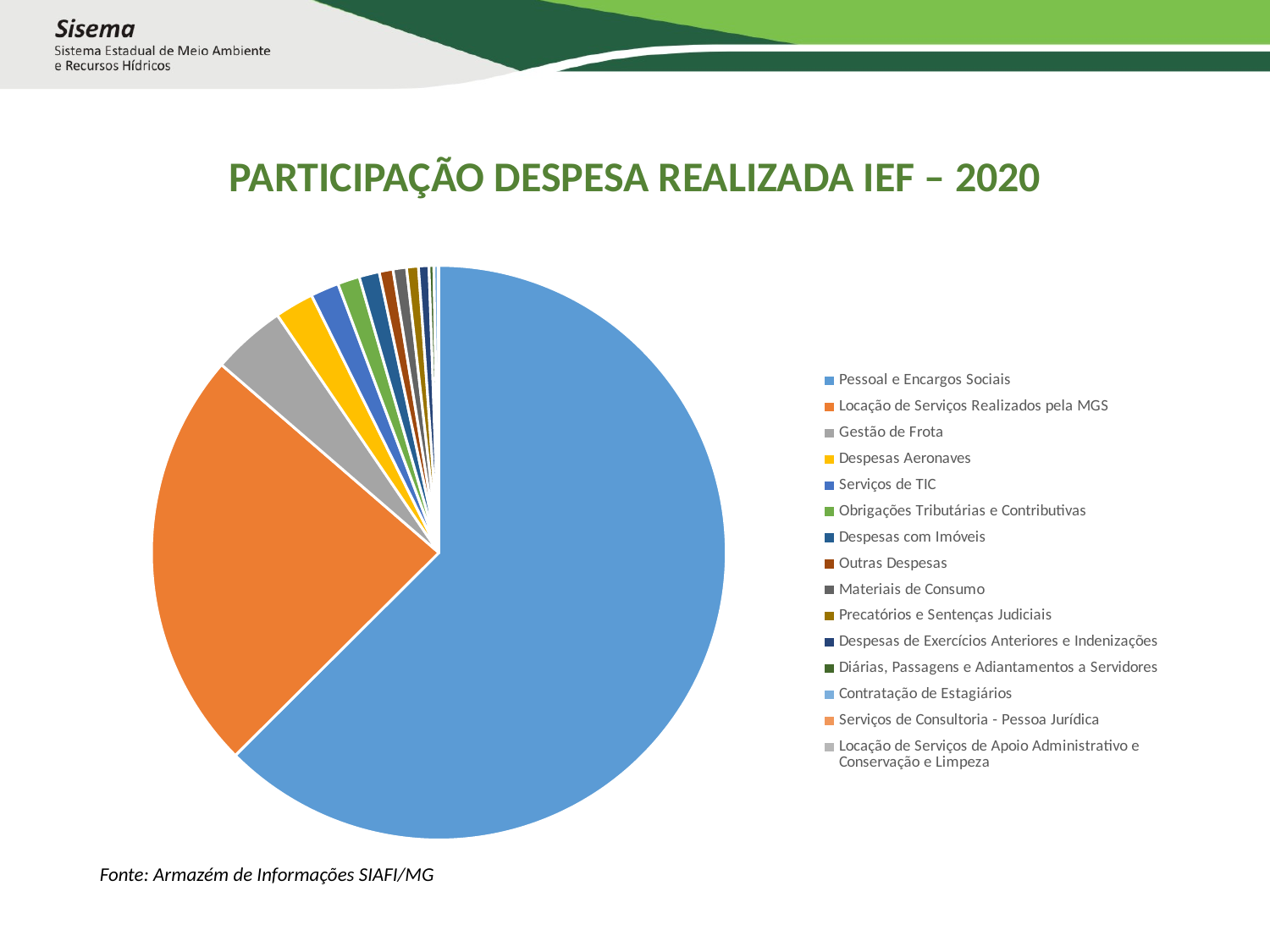
Which slice is larger: Gestão de Frota or Despesas Aeronaves? Gestão de Frota How many categories does the legend of the pie chart list? 15 Which slice is larger: Pessoal e Encargos Sociais or Locação de Serviços Realizados pela MGS? Pessoal e Encargos Sociais What colour is the slice for Locação de Serviços Realizados pela MGS? Orange Which category is listed first in the legend of the pie chart? Pessoal e Encargos Sociais Which category has the second-largest slice of the pie chart? Locação de Serviços Realizados pela MGS Which category has the largest slice of the pie chart? Pessoal e Encargos Sociais What kind of chart is shown on the slide? Pie chart Which slice is larger: Locação de Serviços Realizados pela MGS or Gestão de Frota? Locação de Serviços Realizados pela MGS What is the title of the chart on the slide? PARTICIPAÇÃO DESPESA REALIZADA IEF – 2020